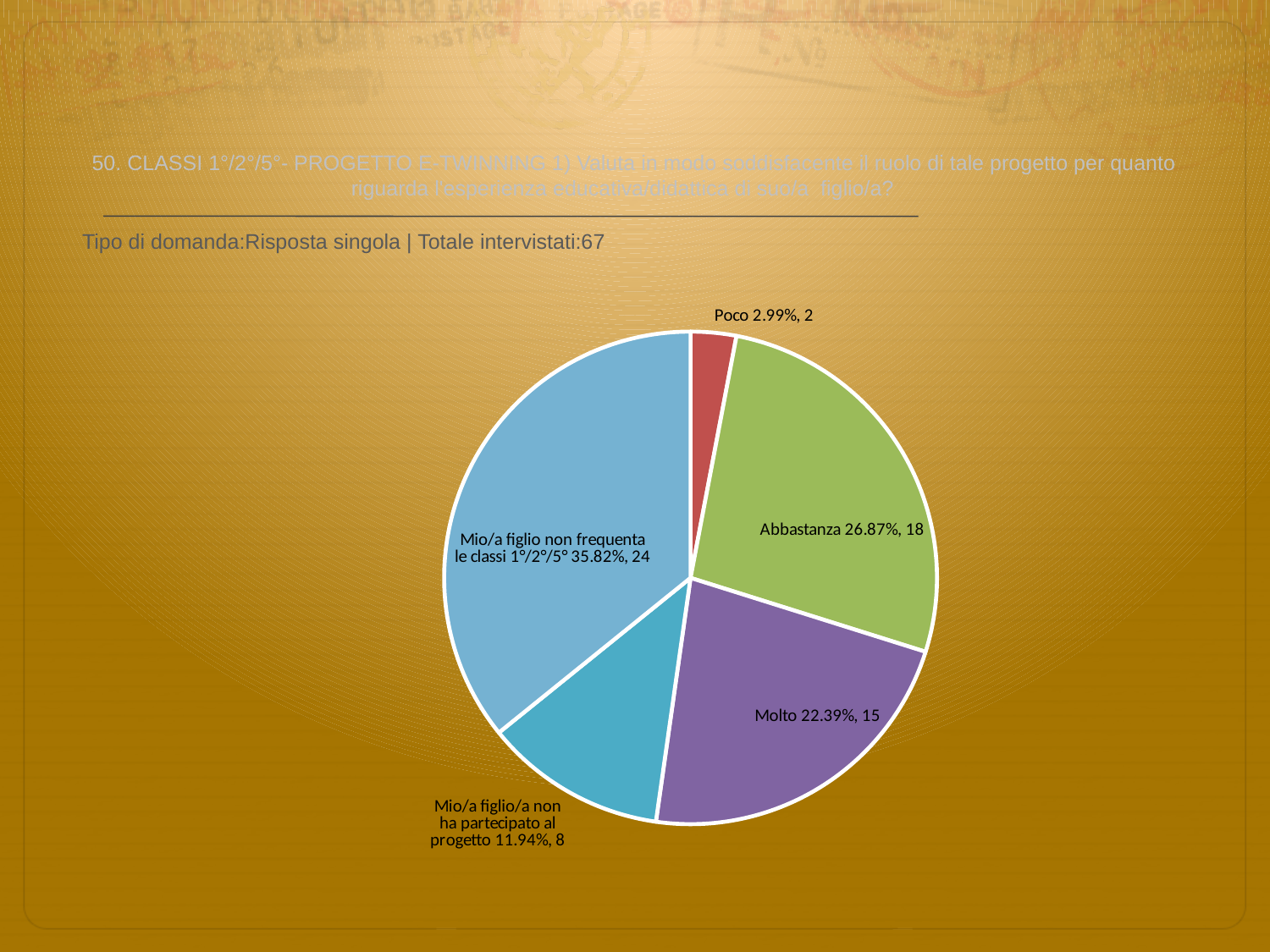
What kind of chart is shown on the slide? pie chart What percentage share does the 'Mio/a figlio/a non ha partecipato al progetto' slice have? 11.94% How many slices does the pie chart have? 5 What colour is the 'Abbastanza' slice? green What is the difference in count between 'Abbastanza' and 'Molto'? 3 Which has a larger share: 'Molto' or 'Mio/a figlio/a non ha partecipato al progetto'? Molto Which category has the largest slice of the pie? Mio/a figlio non frequenta le classi 1°/2°/5° How many respondents answered 'Abbastanza'? 18 What is the total number of respondents stated on the slide? 67 What is the count for the 'Poco' slice? 2 What percentage share does the 'Molto' slice have? 22.39% Which category has the smallest slice of the pie? Poco